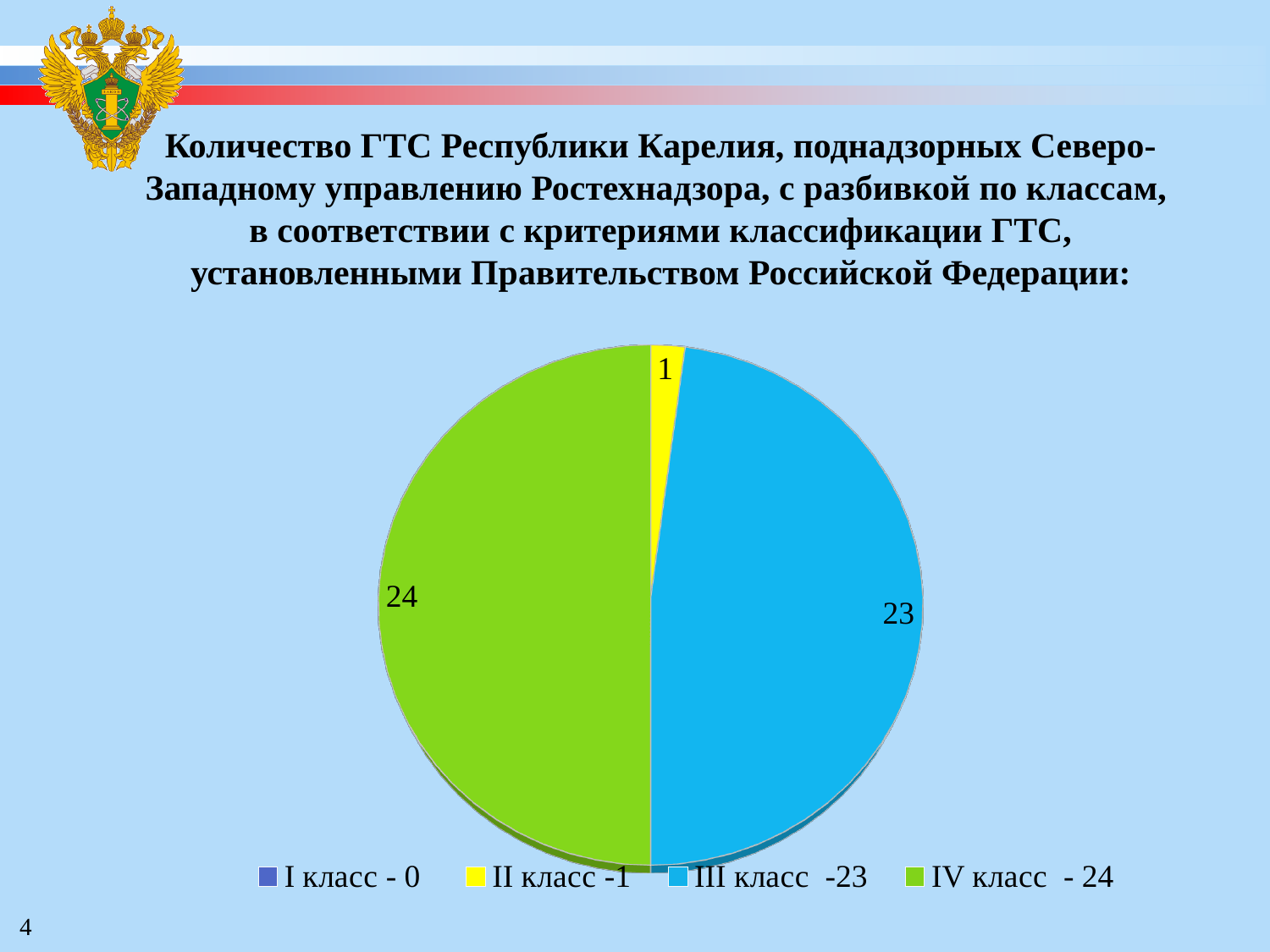
How many entries does the legend list? 4 Which class with a visible slice has the smallest value? II класс What is the value for IV класс? 24 What is the value for I класс according to the legend? 0 What is the value for II класс? 1 What share of the total does IV класс represent? 50% What is the difference between the values for IV класс and III класс? 1 What type of chart is shown on the slide? pie chart What is the difference between the values for III класс and II класс? 22 What is the value for III класс? 23 Which class has the largest slice of the pie? IV класс What colour is the slice for III класс? blue